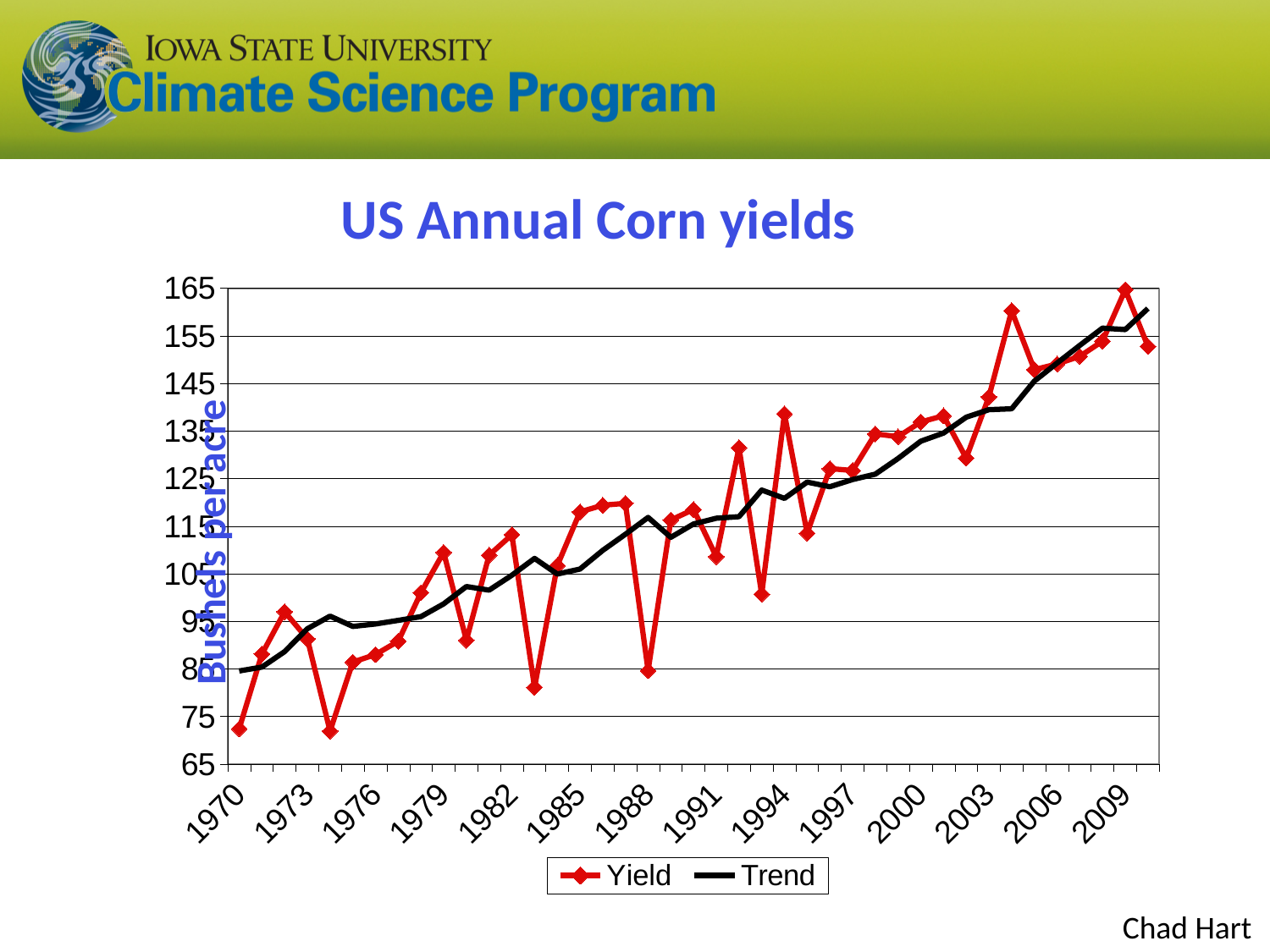
Which year has the larger Yield value, 1994 or 1995? 1994 In which year is the Yield series at its highest? 2009 Is the Yield value for 1994 greater or less than 135? greater Is the Yield value for 1970 greater or less than 85? less Overall, do corn yields rise or fall from 1970 to 2010? rise Which year has the larger Yield value, 1982 or 1983? 1982 Is the Yield value for 2009 greater or less than 155? greater What is the title of the chart? US Annual Corn yields How many series does the legend list? 2 What kind of chart is shown on the slide? line chart What are the two series named in the legend? Yield and Trend